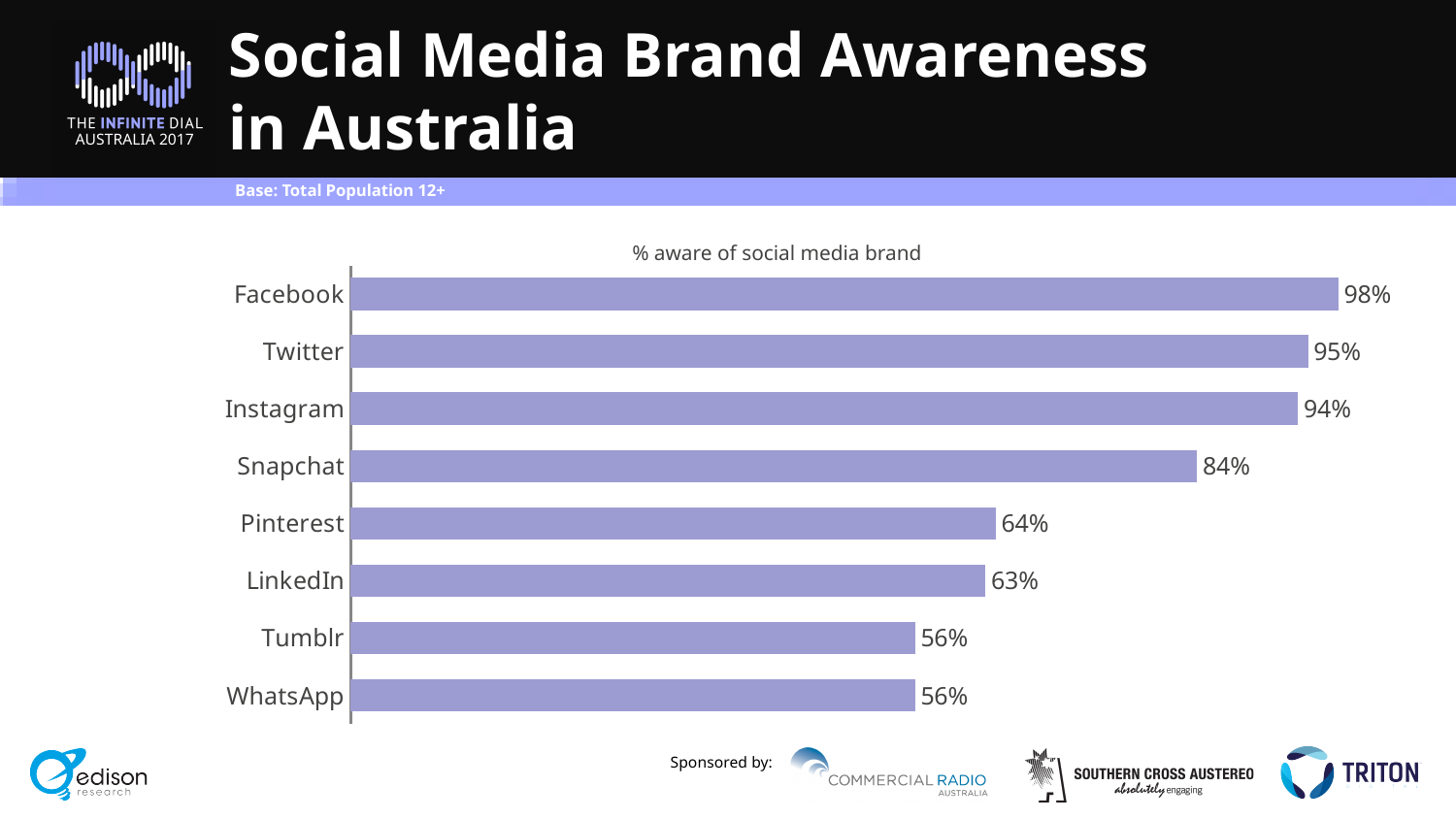
How many social media brands are shown on the chart? 8 What is the title shown above the chart? % aware of social media brand What type of chart is used on this slide? Bar chart What base population is stated for the chart? Total Population 12+ What percentage is shown for LinkedIn? 63% What is the awareness value shown for Snapchat? 84% What percentage of the population is aware of Facebook? 98% What is the difference between Twitter's and Instagram's awareness values? 1% Which brands share the lowest awareness value on the chart? Tumblr and WhatsApp Which has higher awareness, Snapchat or Pinterest? Snapchat What is the difference in awareness between Facebook and Snapchat? 14% Which social media brand has the highest awareness? Facebook